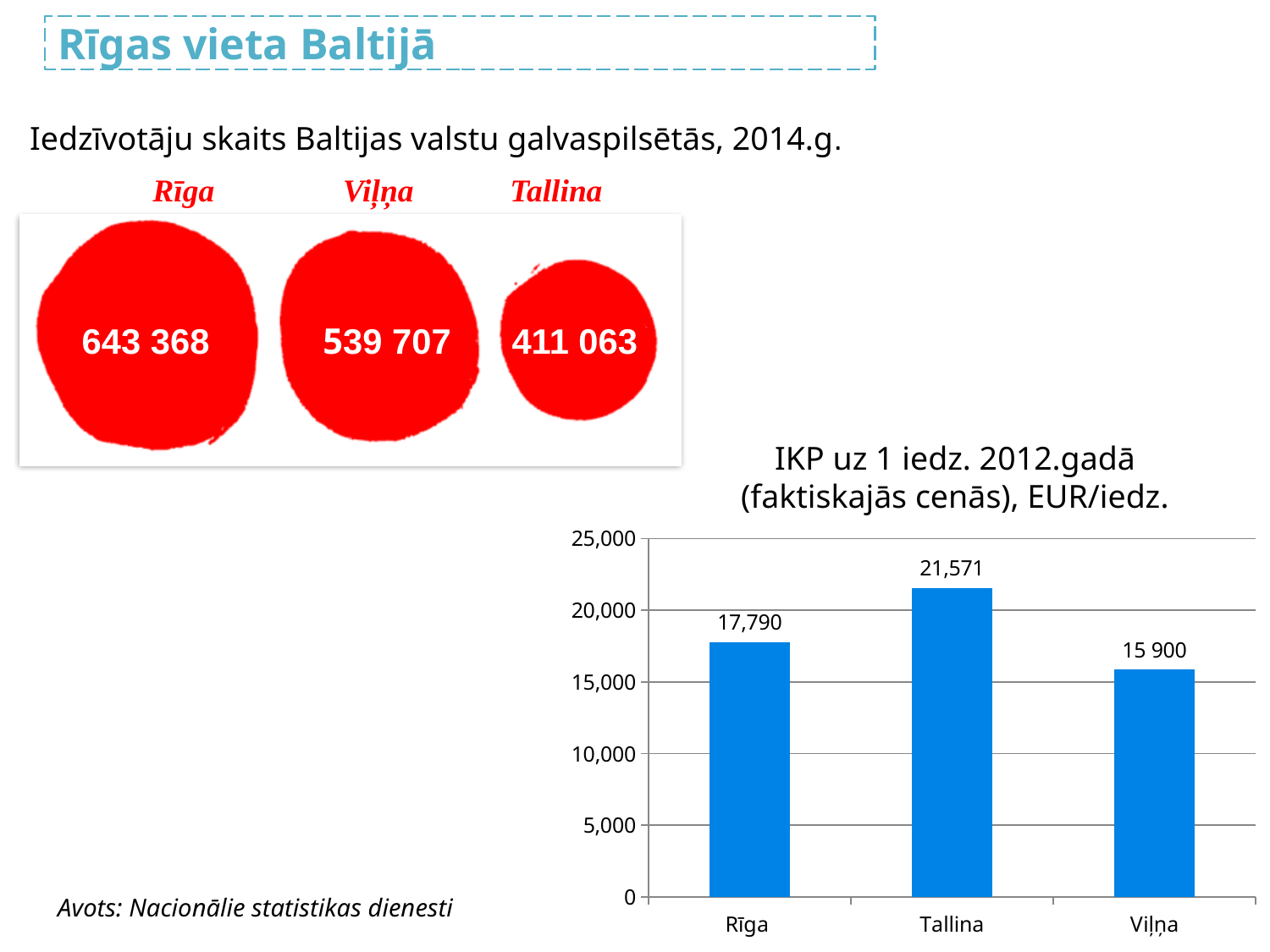
In the bar chart 'IKP uz 1 iedz. 2012.gadā', what is the difference between the values for Rīga and Viļņa? 1,890 In the bar chart 'IKP uz 1 iedz. 2012.gadā', what is the difference between the values for Tallina and Rīga? 3,781 How many cities are shown in the bar chart 'IKP uz 1 iedz. 2012.gadā'? 3 In the bar chart 'IKP uz 1 iedz. 2012.gadā', which is larger, the value for Rīga or the value for Viļņa? Rīga In the bar chart 'IKP uz 1 iedz. 2012.gadā', what is the value for Tallina? 21,571 In the bar chart 'IKP uz 1 iedz. 2012.gadā', what is the maximum value shown on the vertical axis? 25,000 In the bar chart 'IKP uz 1 iedz. 2012.gadā', what is the value for Viļņa? 15 900 In the bar chart 'IKP uz 1 iedz. 2012.gadā', which city has the highest value? Tallina What kind of chart is 'IKP uz 1 iedz. 2012.gadā'? bar chart In the bar chart 'IKP uz 1 iedz. 2012.gadā', what is the value for Rīga? 17,790 In the bar chart 'IKP uz 1 iedz. 2012.gadā', which city has the lowest value? Viļņa In the bar chart 'IKP uz 1 iedz. 2012.gadā', is the value for Tallina greater or less than 20,000? greater